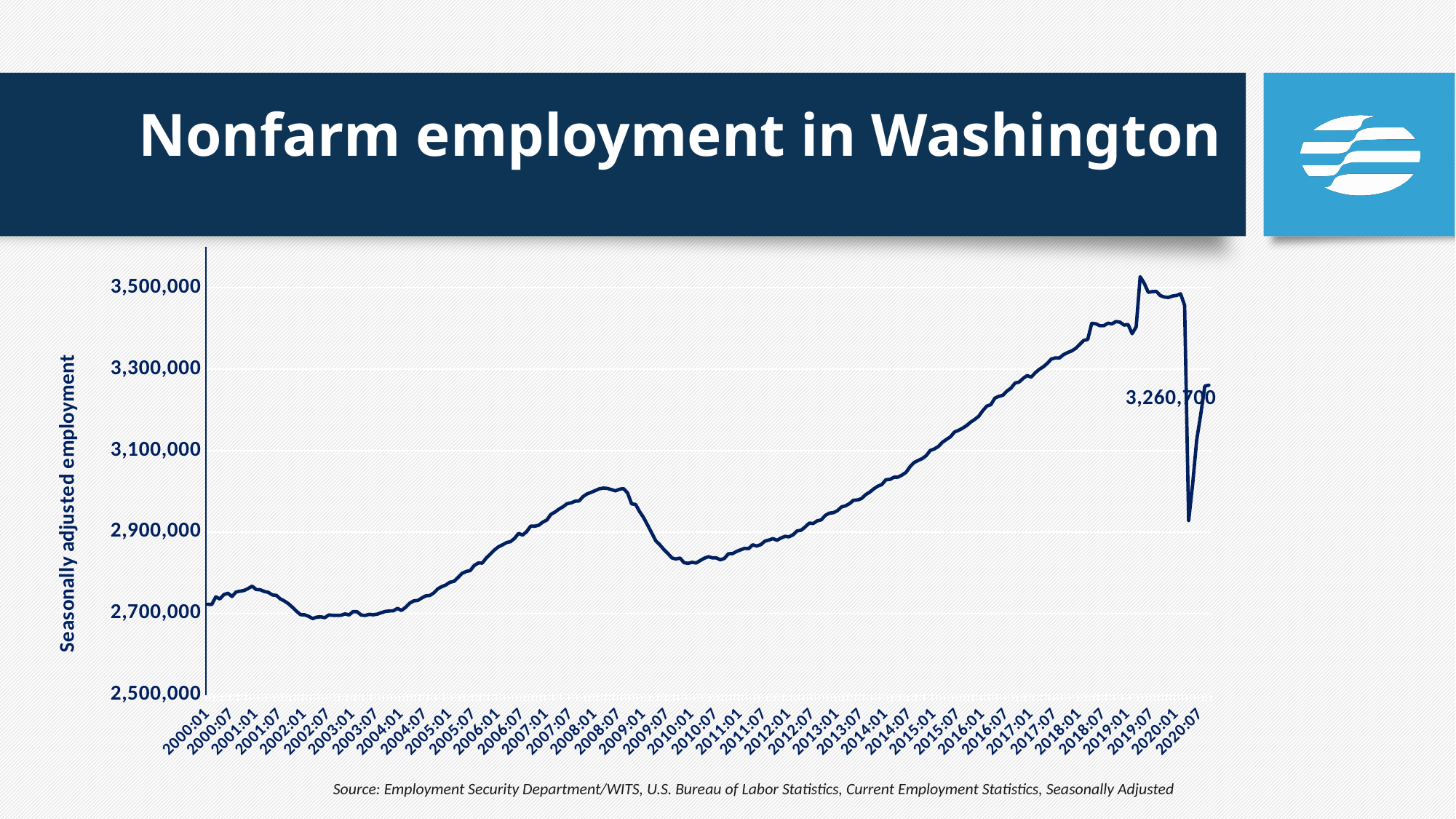
What kind of chart is shown on the slide? line chart Is the value at 2010:01 greater or less than 2,900,000? less Which is larger, the value at 2008:01 or the value at 2010:01? 2008:01 Is the value at 2019:07 greater or less than 3,300,000? greater What value is printed as the data label at the end of the line? 3,260,700 Is the value at 2000:01 greater or less than 2,900,000? less What is the title of the chart? Nonfarm employment in Washington Does the line rise or fall between 2008:07 and 2009:07? fall How many lines are plotted on the chart? 1 What is the label on the vertical axis of the chart? Seasonally adjusted employment Does the line rise or fall between 2010:01 and 2018:07? rise